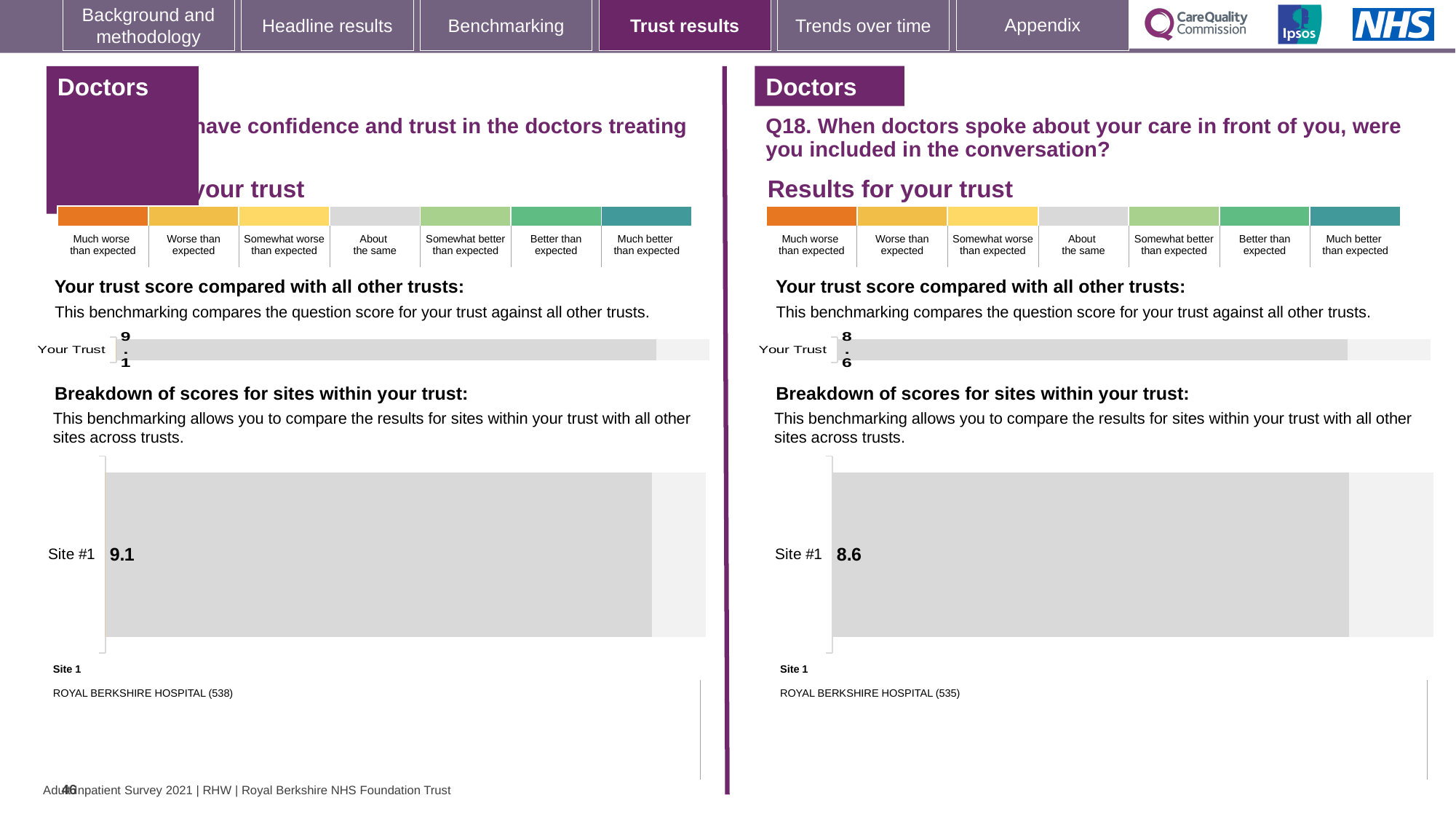
What is the difference between the Site #1 score on the left-hand chart and the Site #1 score on the right-hand chart (Q18)? 0.5 What kind of chart is used to show the Site #1 score on the right-hand side of the slide? Bar chart On the left-hand side, what number appears in brackets after ROYAL BERKSHIRE HOSPITAL for Site 1? 538 How many sites are shown in the right-hand breakdown of scores for sites within your trust (Q18)? 1 On the left-hand chart (confidence and trust in doctors), what is the score shown for Your Trust? 9.1 On the right-hand chart for Q18, what is the score shown for Your Trust? 8.6 In the left-hand breakdown of scores for sites, what is the score for Site #1? 9.1 In the right-hand breakdown of scores for sites (Q18), what is the score for Site #1? 8.6 On the right-hand side (Q18), which hospital is listed as Site 1 below the breakdown chart? ROYAL BERKSHIRE HOSPITAL (535) Which is larger: the Site #1 score on the left-hand chart or the Site #1 score on the right-hand chart (Q18)? The left-hand chart (9.1) Which is larger: the Your Trust score on the left-hand chart or the Your Trust score on the right-hand chart (Q18)? The left-hand chart (9.1)